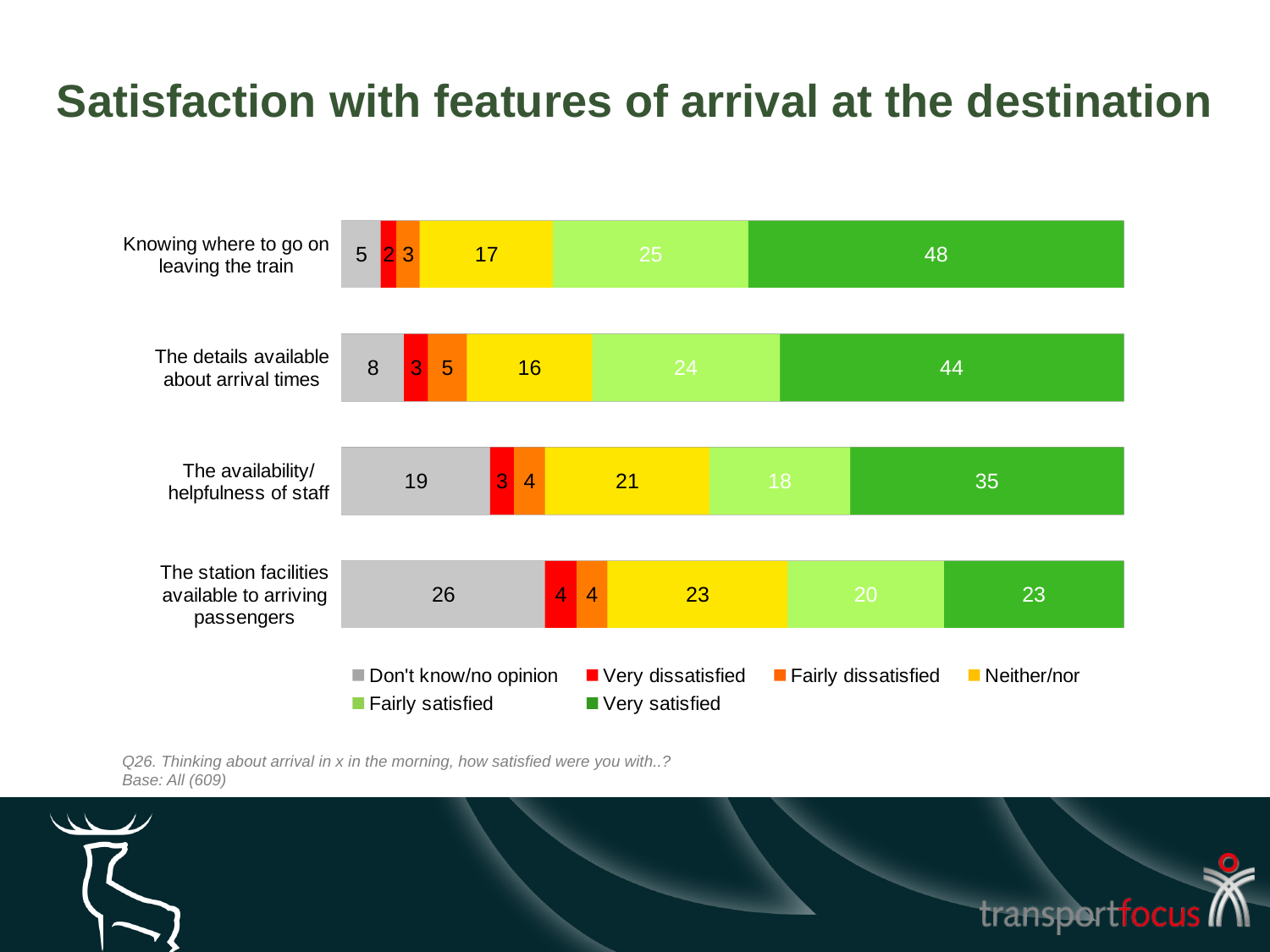
What is the difference between the 'Very satisfied' values for 'Knowing where to go on leaving the train' and 'The station facilities available to arriving passengers'? 25 How many categories are shown in the chart? 4 What is the total of the stacked bar for 'The details available about arrival times'? 100 What kind of chart is shown on the slide? Stacked bar chart Which is larger: the 'Fairly satisfied' value for 'The availability/helpfulness of staff' or for 'The station facilities available to arriving passengers'? The station facilities available to arriving passengers How many series does the legend list? 6 What is the 'Don't know/no opinion' value for 'The station facilities available to arriving passengers'? 26 What is the 'Fairly satisfied' value for 'The details available about arrival times'? 24 Which category has the lowest 'Don't know/no opinion' value? Knowing where to go on leaving the train Which category has the highest 'Very satisfied' value? Knowing where to go on leaving the train What is the 'Very satisfied' value for 'Knowing where to go on leaving the train'? 48 What is the 'Neither/nor' value for 'The availability/helpfulness of staff'? 21